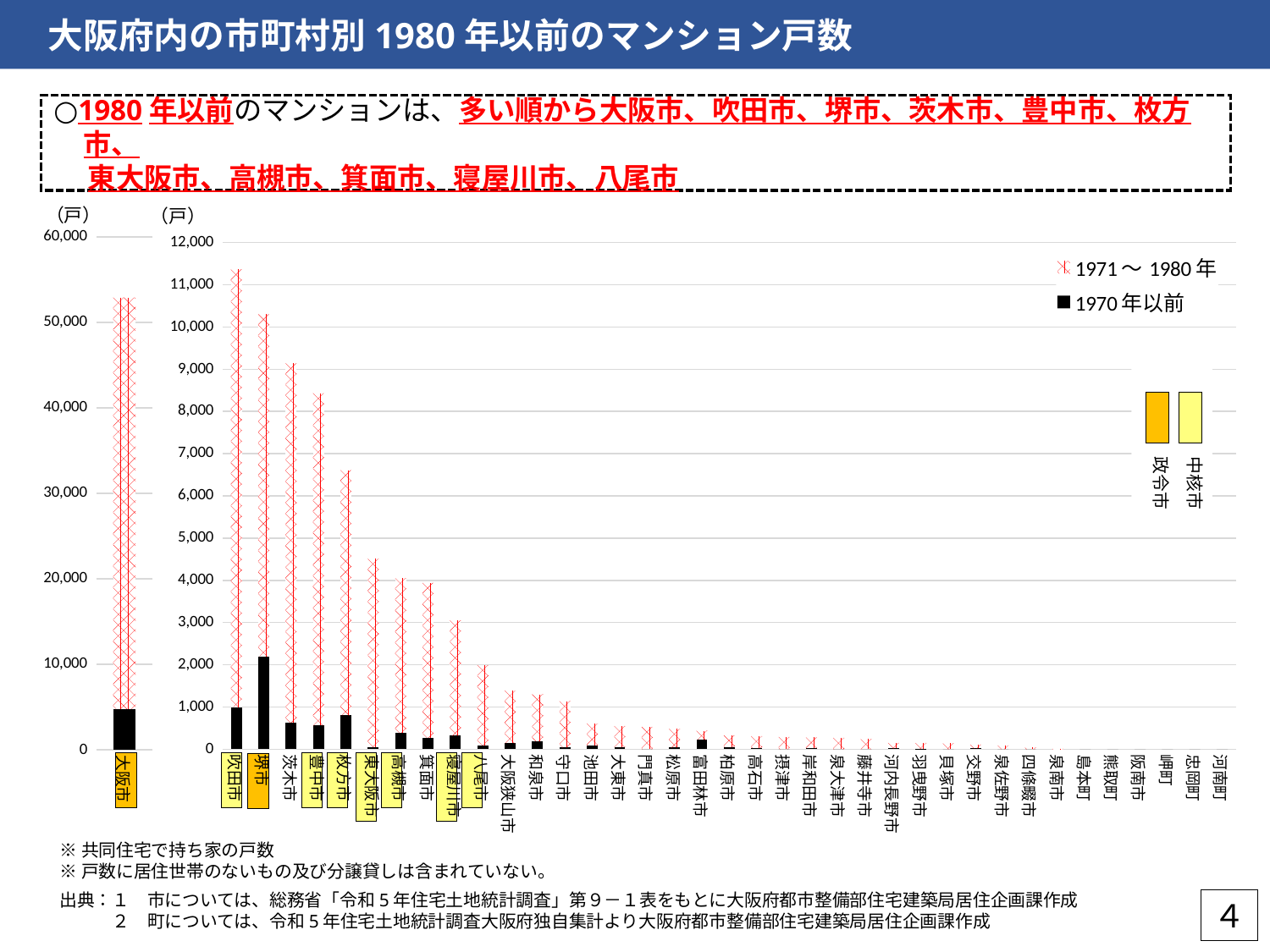
What kind of chart is used on this slide to show the number of condominium units by municipality? bar chart In the right-hand chart, is the total value for 箕面市 greater or less than 3,000? greater How many series does the legend list? 2 In the right-hand chart (axis up to 12,000), which municipality has the highest total number of units? 吹田市 In the right-hand chart, is the total value for 枚方市 greater or less than 7,000? less In the right-hand chart, is the total value for 吹田市 greater or less than 10,000? greater In the right-hand chart, which has the larger total, 茨木市 or 豊中市? 茨木市 In the right-hand chart, which has the larger 1970年以前 (black) portion, 堺市 or 吹田市? 堺市 In the right-hand chart, do the total values rise or fall moving from left to right along the x axis? fall In the right-hand chart, which has the larger total, 寝屋川市 or 八尾市? 寝屋川市